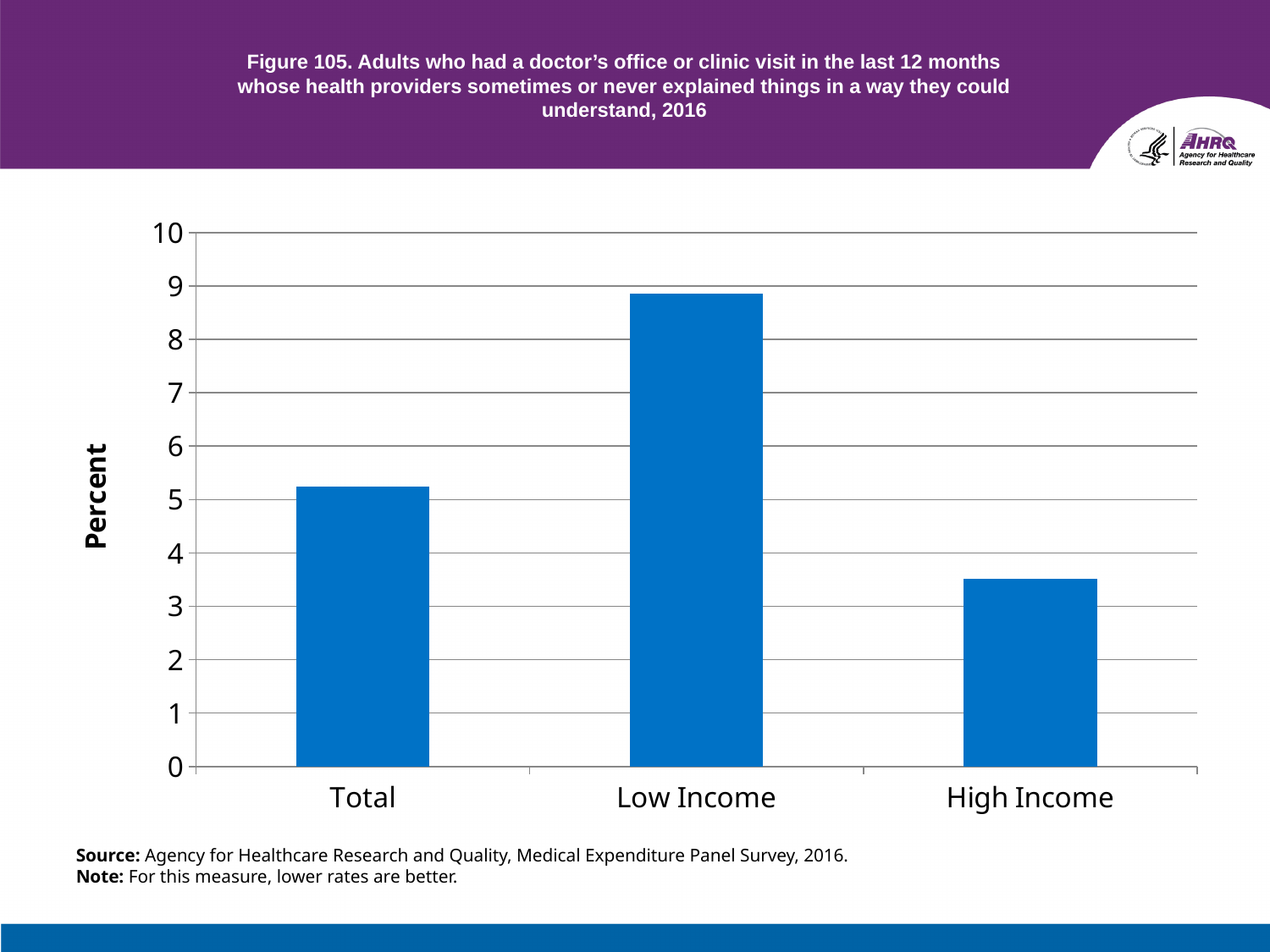
Which category has the lowest value? High Income What is the maximum value shown on the y axis? 10 Which is larger, the value for Low Income or the value for Total? Low Income How many categories are shown on the x axis? 3 Is the value for High Income greater or less than 4? less What is the label of the y axis? Percent Is the value for Low Income greater or less than 9? less Which is larger, the value for Total or the value for High Income? Total What kind of chart is shown on the slide? bar chart Which category has the highest value? Low Income Is the value for Low Income greater or less than 8? greater